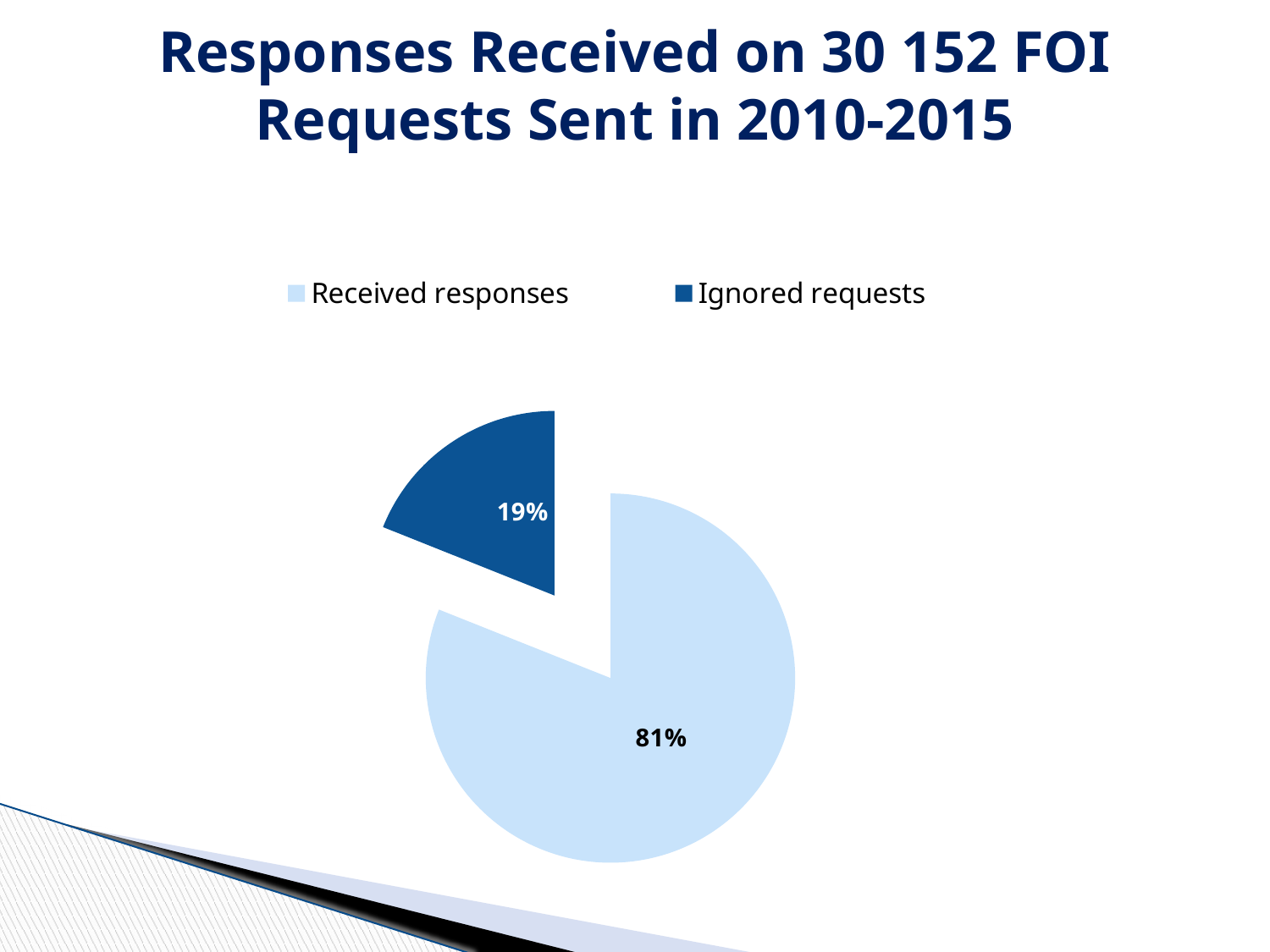
What share of the pie is labelled "Ignored requests"? 19% Which slice of the pie is the smallest? Ignored requests What kind of chart is shown on the slide? Pie chart How many slices does the pie chart have? 2 What is the title of the chart? Responses Received on 30 152 FOI Requests Sent in 2010-2015 How many entries does the legend list? 2 What is the difference in percentage points between the "Received responses" slice and the "Ignored requests" slice? 62 Which slice is shown in dark blue? Ignored requests What share of the pie is labelled "Received responses"? 81% Which is larger, the "Received responses" slice or the "Ignored requests" slice? Received responses What is the total of the two percentages shown on the pie chart? 100% Which slice of the pie is the largest? Received responses